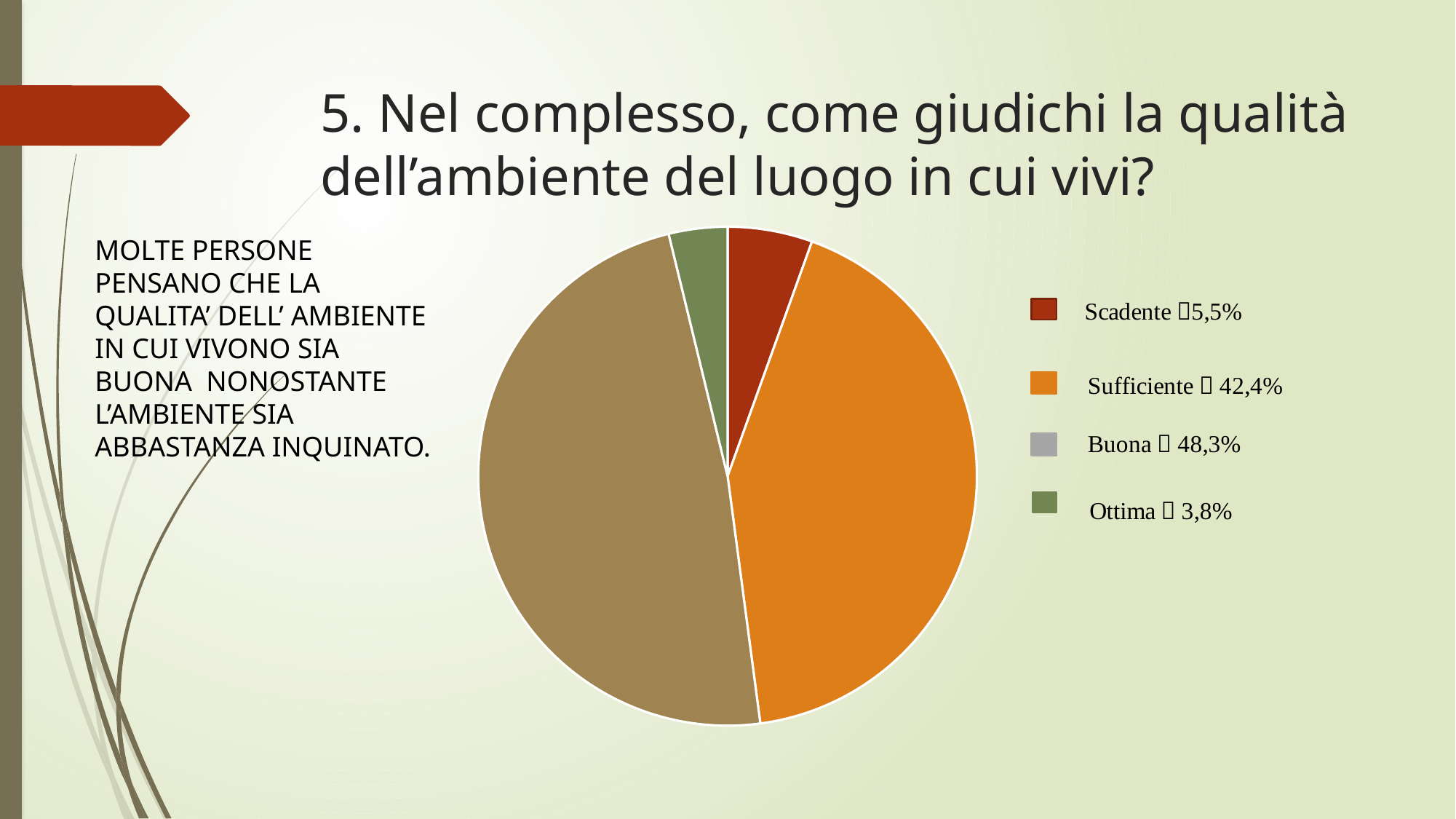
What colour is the slice for Sufficiente? orange What percentage of respondents rated the environment quality as Sufficiente? 42,4% What percentage of respondents rated the environment quality as Buona? 48,3% How many categories does the pie chart have? 4 What is the difference between the Buona and Sufficiente shares? 5,9% What percentage of respondents rated the environment quality as Ottima? 3,8% Which category has the largest share of the pie? Buona Which category has the smallest share of the pie? Ottima What kind of chart is shown on the slide? pie chart What is the difference between the Scadente and Ottima shares? 1,7% Which is larger, the share for Scadente or the share for Ottima? Scadente What percentage of respondents rated the environment quality as Scadente? 5,5%